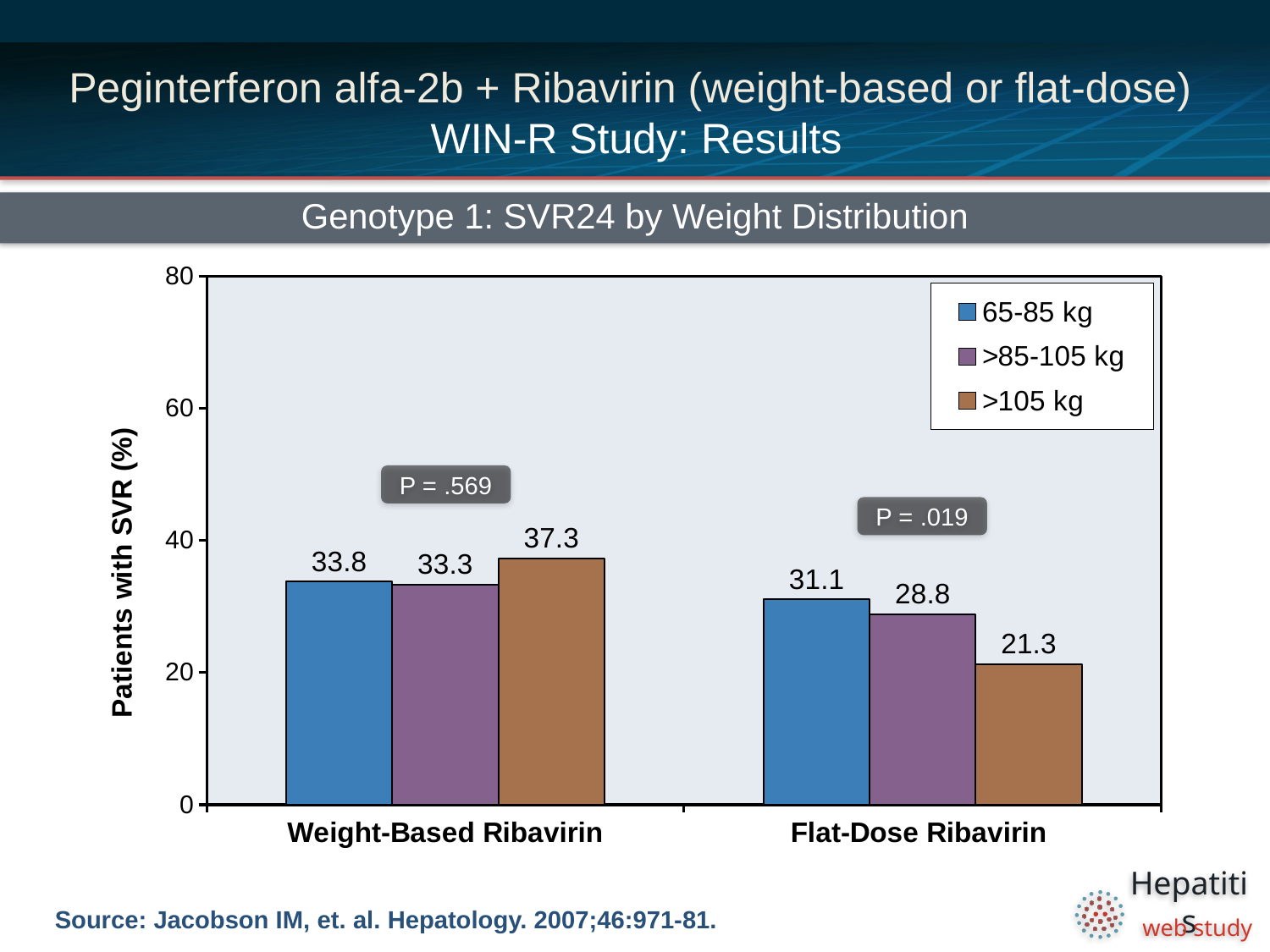
How many series does the legend list? 3 What is the difference in SVR rate between the 65-85 kg and >105 kg groups with Flat-Dose Ribavirin? 9.8 What is the SVR rate for the >85-105 kg group with Flat-Dose Ribavirin? 28.8 How many treatment categories are shown on the x axis? 2 What kind of chart is shown on the slide? bar chart Which is larger: the SVR rate for the >105 kg group with Weight-Based Ribavirin or with Flat-Dose Ribavirin? Weight-Based Ribavirin Which weight group has the lowest SVR rate with Flat-Dose Ribavirin? >105 kg Which weight group has the highest SVR rate with Weight-Based Ribavirin? >105 kg What is the SVR rate for the >105 kg group with Flat-Dose Ribavirin? 21.3 What is the P value shown for the Flat-Dose Ribavirin group? P = .019 What is the SVR rate for the 65-85 kg group with Weight-Based Ribavirin? 33.8 Is the SVR rate for the >105 kg group with Flat-Dose Ribavirin greater or less than 40? less